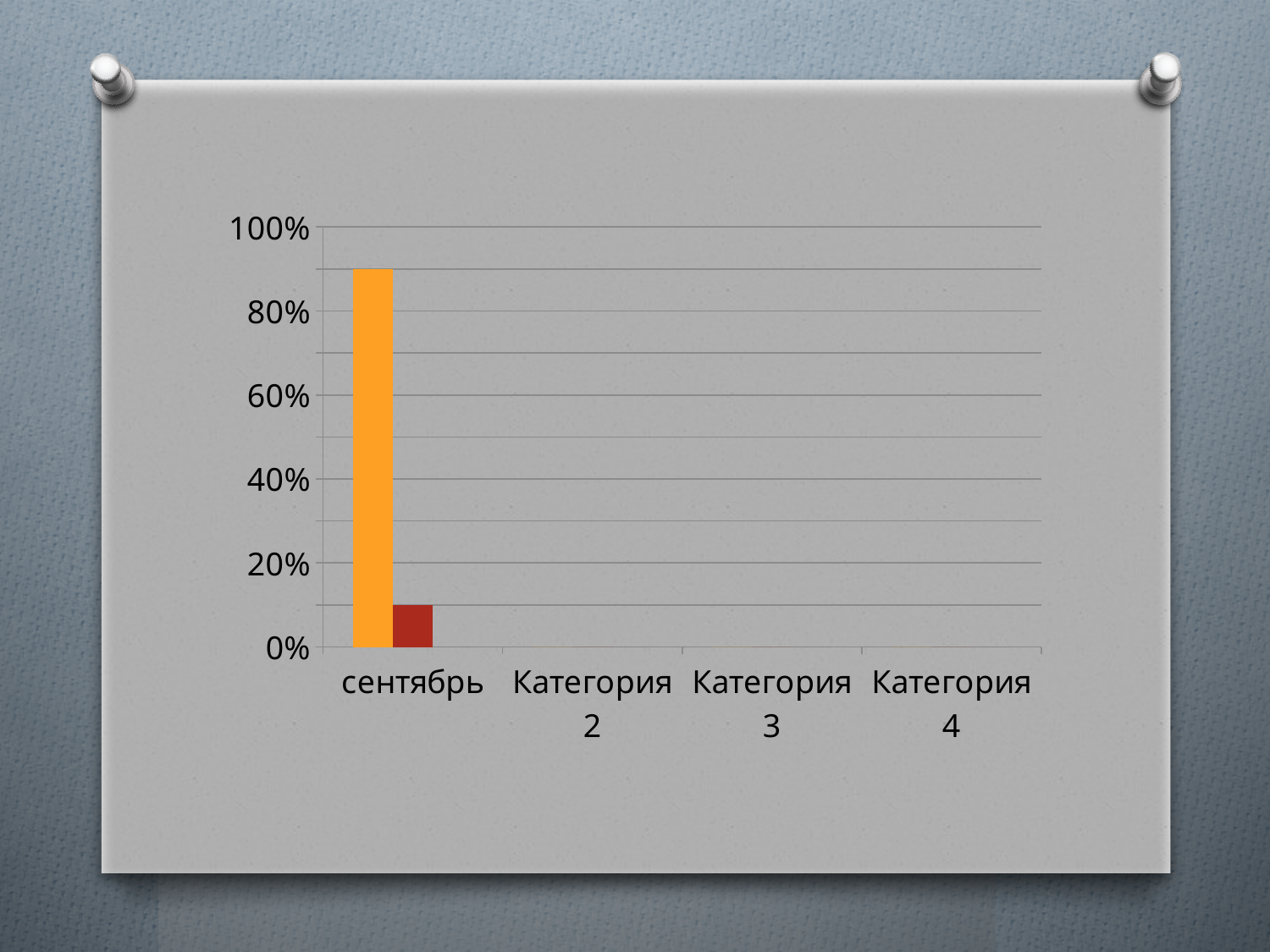
How many categories are labelled on the horizontal axis? 4 What kind of chart is shown on the slide? bar chart Which category has the tallest bar? сентябрь Is the value of the orange bar for сентябрь greater or less than 80%? greater What is the label of the first category on the horizontal axis? сентябрь Is the value of the red bar for сентябрь greater or less than 20%? less Is the value of the orange bar for сентябрь greater or less than 100%? less How many bars are actually plotted on the chart? 2 For сентябрь, which bar is taller, the orange one or the red one? the orange one What is the highest value labelled on the vertical axis? 100%